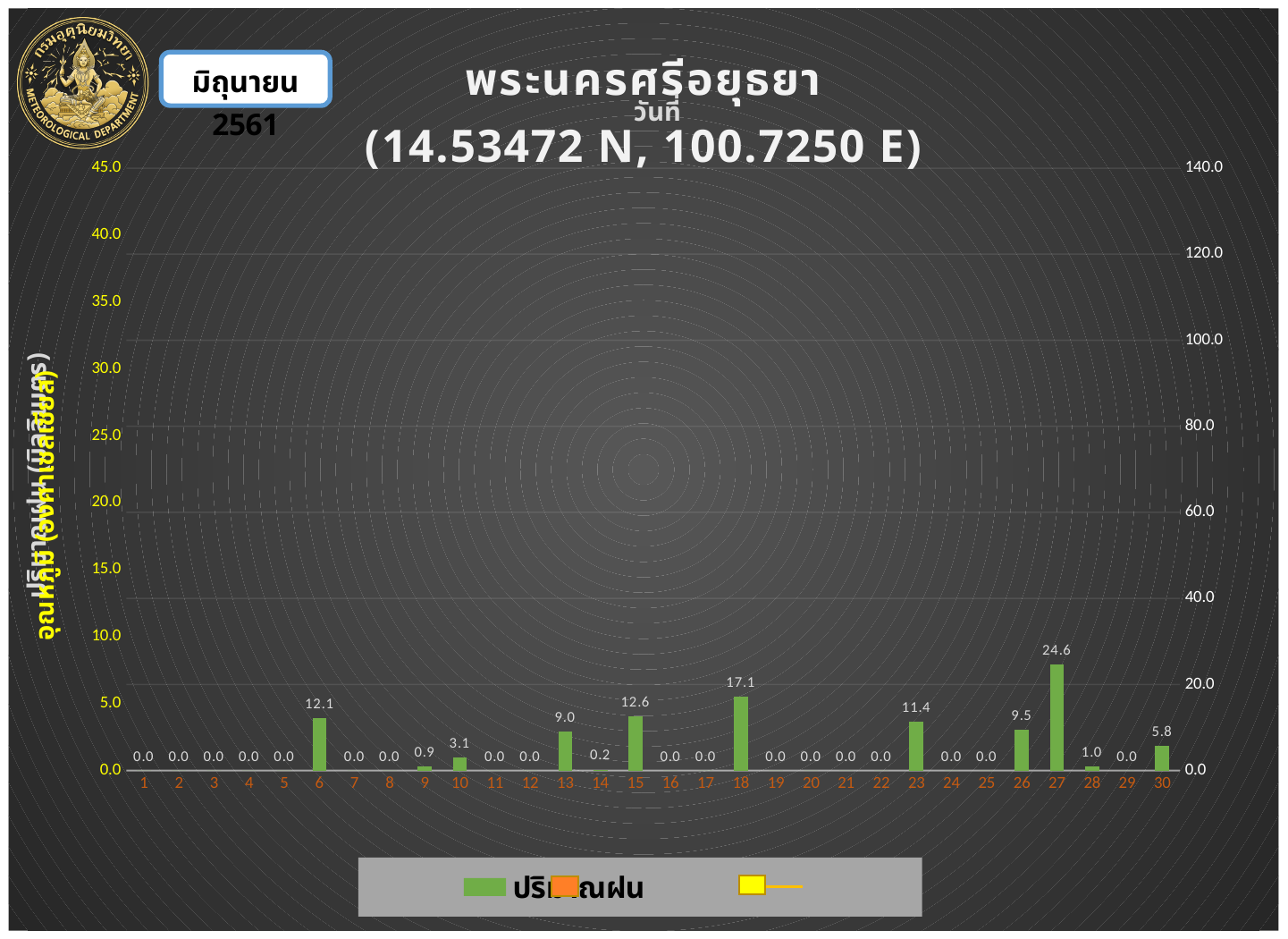
Which is larger, the value for day 13 or the value for day 30? day 13 What is the rainfall value shown for day 27? 24.6 What is the difference between the values for day 15 and day 6? 0.5 What coordinates are given in the chart title? 14.53472 N, 100.7250 E What kind of chart is shown on the slide? bar chart What is the value labelled on the bar for day 18? 17.1 What value is shown for day 14? 0.2 How many days are shown on the x axis? 30 Which is larger, the value for day 23 or the value for day 26? day 23 Which day has the highest bar? 27 What is the difference between the values for day 27 and day 18? 7.5 What value is shown for day 10? 3.1